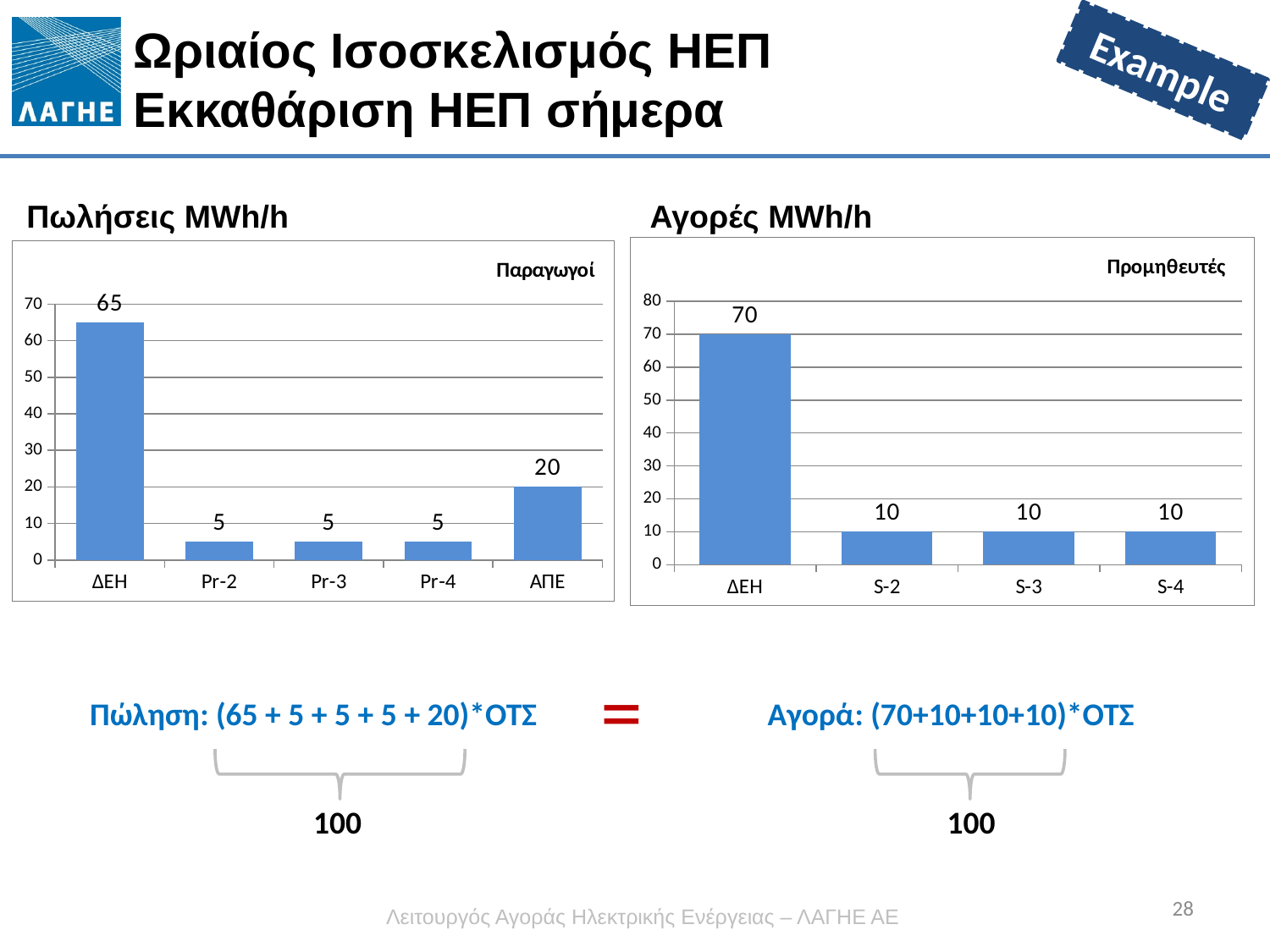
In the Πωλήσεις MWh/h chart, what is the value for ΑΠΕ? 20 In the Αγορές MWh/h chart, what is the value for S-3? 10 In the Αγορές MWh/h chart, what is the difference between the values for ΔΕΗ and S-2? 60 Which is larger: the value for ΔΕΗ in the Πωλήσεις MWh/h chart or the value for ΔΕΗ in the Αγορές MWh/h chart? ΔΕΗ in the Αγορές MWh/h chart In the Πωλήσεις MWh/h chart, what is the difference between the values for ΔΕΗ and ΑΠΕ? 45 In the Αγορές MWh/h chart, how many categories are shown on the x axis? 4 In the Πωλήσεις MWh/h chart, what is the value for ΔΕΗ? 65 In the Πωλήσεις MWh/h chart, how many categories are shown on the x axis? 5 In the Πωλήσεις MWh/h chart, what is the legend entry shown? Παραγωγοί In the Αγορές MWh/h chart, what is the value for ΔΕΗ? 70 What type of chart is the Αγορές MWh/h chart? Bar chart In the Πωλήσεις MWh/h chart, which category has the highest value? ΔΕΗ